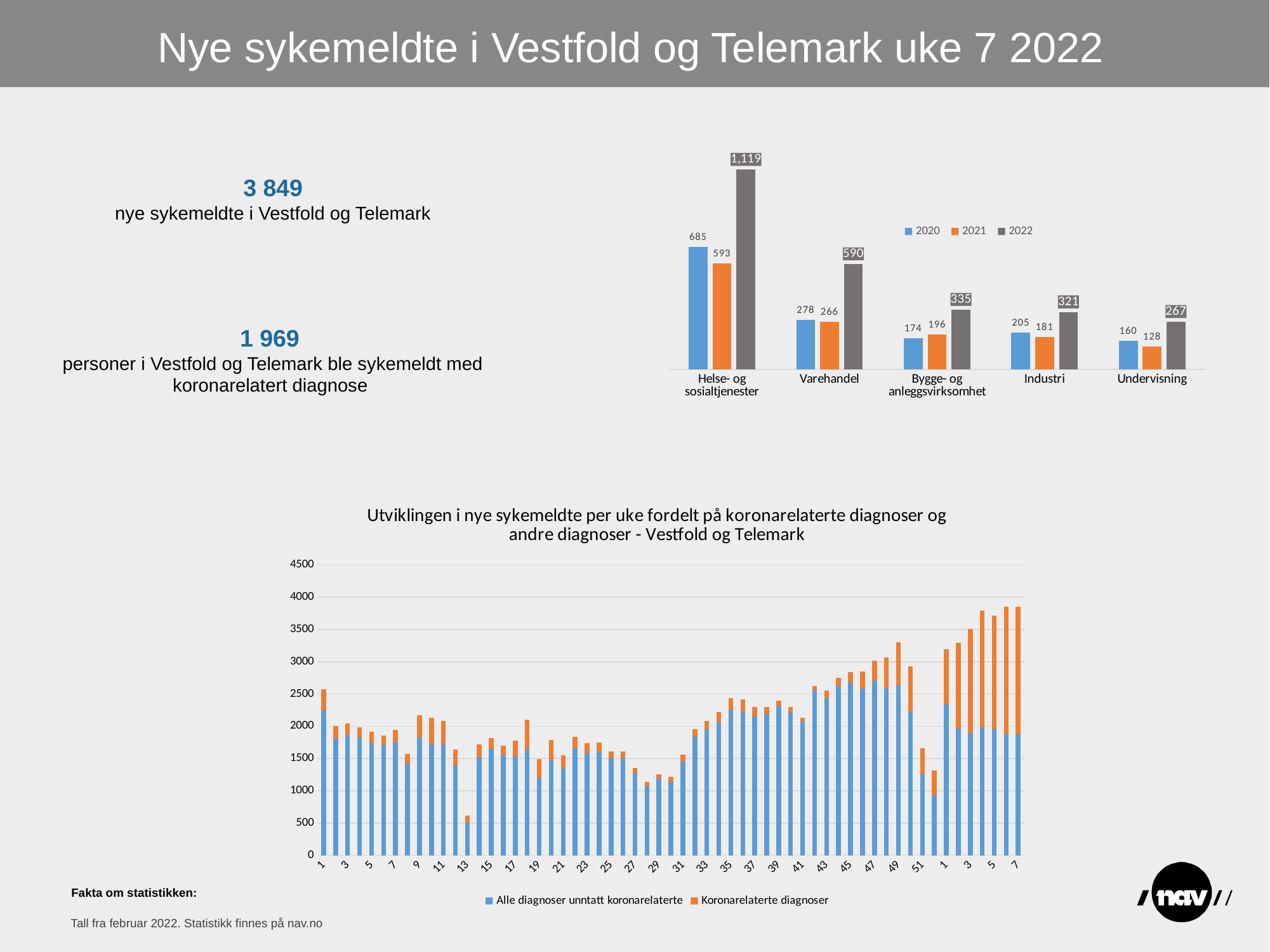
In the bottom chart 'Utviklingen i nye sykemeldte per uke...', is the total for week 13 greater or less than 1000? less In the top-right bar chart, which category has the lowest 2020 value? Undervisning In the top-right bar chart, which category has the highest 2022 value? Helse- og sosialtjenester What kind of chart is the bottom chart 'Utviklingen i nye sykemeldte per uke...'? Stacked bar chart How many categories are shown on the x axis of the top-right bar chart? 5 In the top-right bar chart, what is the 2022 value for Helse- og sosialtjenester? 1,119 In the top-right bar chart, what is the 2021 value for Undervisning? 128 How many series does the legend of the top-right bar chart list? 3 In the top-right bar chart, what is the 2020 value for Varehandel? 278 In the top-right bar chart, which is larger for Bygge- og anleggsvirksomhet: the 2020 value or the 2021 value? 2021 In the bottom chart 'Utviklingen i nye sykemeldte per uke...', is the total for the last week (7) greater or less than 3500? greater In the top-right bar chart, what is the difference between the 2022 and 2021 values for Varehandel? 324